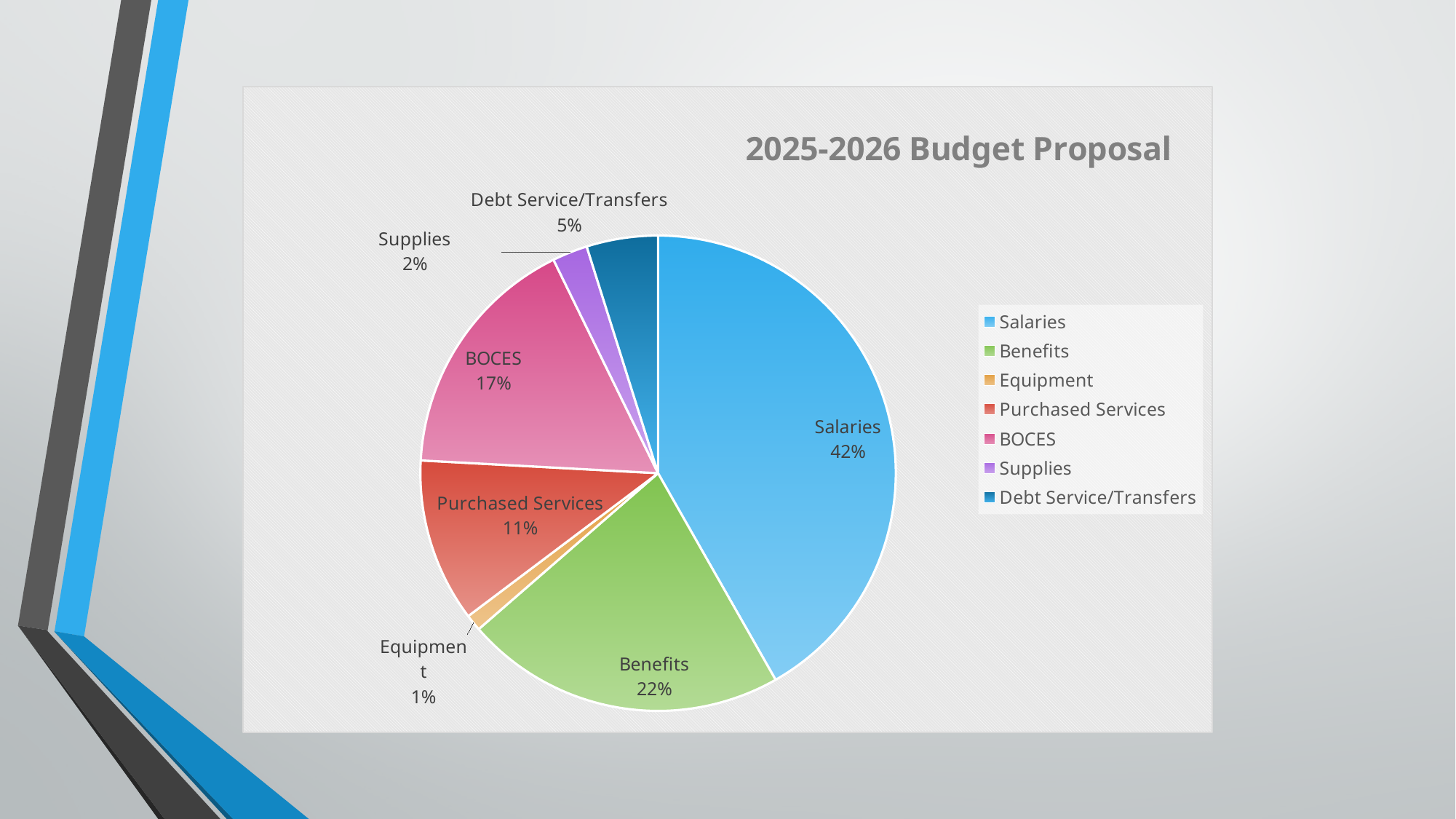
What kind of chart is shown on the slide? pie chart What share of the budget is Salaries? 42% Which category has the largest share of the budget? Salaries What share of the budget is Debt Service/Transfers? 5% What is the difference in percentage points between Benefits and Purchased Services? 11 Which is larger, BOCES or Purchased Services? BOCES What is the title of the chart? 2025-2026 Budget Proposal Which category has the smallest share of the budget? Equipment What share of the budget is BOCES? 17% How many categories does the pie chart have? 7 What is the combined share of Salaries and Benefits? 64% How many entries does the legend list? 7